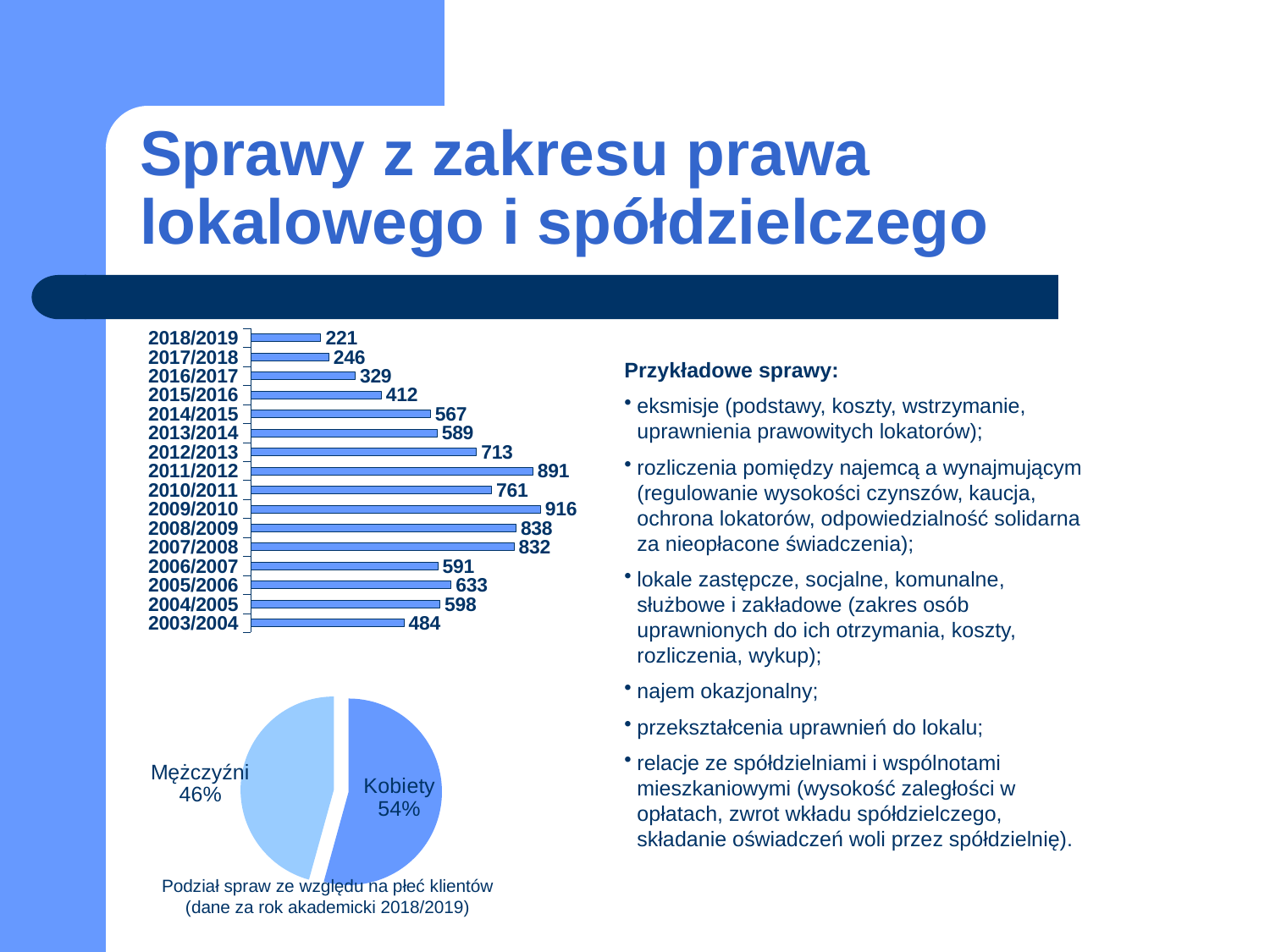
What kind of chart is the upper chart on the slide? Bar chart In the pie chart, what share of cases is for Kobiety? 54% In the bar chart, what is the value for 2018/2019? 221 In the bar chart, do the values rise or fall from 2015/2016 to 2018/2019? Fall In the bar chart, what is the value for 2009/2010? 916 In the bar chart, which academic year has the highest value? 2009/2010 In the bar chart, what is the value for 2003/2004? 484 How many academic years are shown in the bar chart? 16 In the bar chart, which academic year has the lowest value? 2018/2019 In the bar chart, what is the difference between the values for 2011/2012 and 2010/2011? 130 In the pie chart, which group has the larger share, Kobiety or Mężczyźni? Kobiety In the bar chart, which is larger, the value for 2005/2006 or the value for 2004/2005? 2005/2006